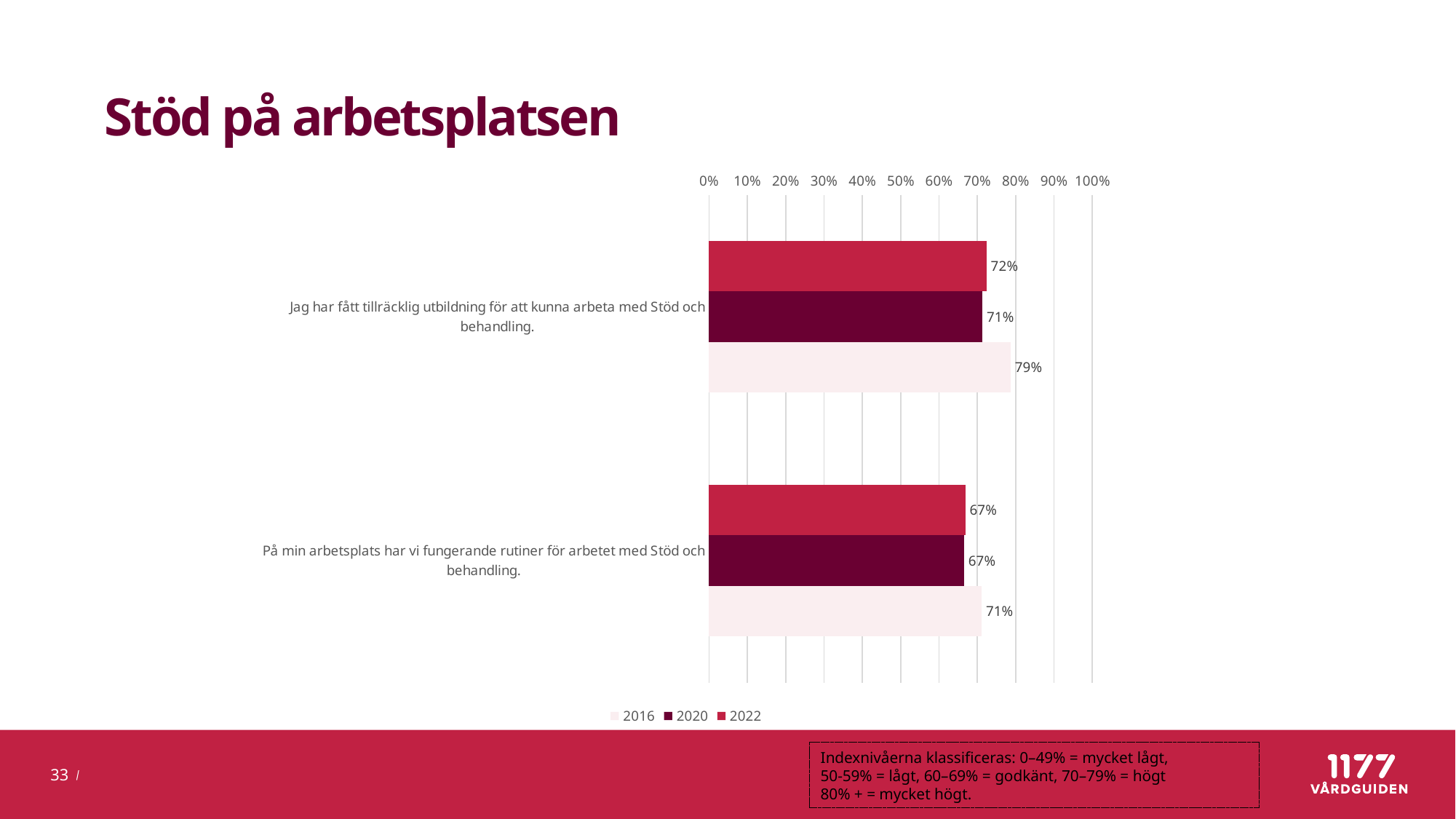
What kind of chart is shown on the slide? Bar chart What is the 2020 value for "Jag har fått tillräcklig utbildning för att kunna arbeta med Stöd och behandling."? 71% How many series does the legend list? 3 What is the 2016 value for "På min arbetsplats har vi fungerande rutiner för arbetet med Stöd och behandling."? 71% What is the difference between the 2016 and 2020 values for "På min arbetsplats har vi fungerande rutiner för arbetet med Stöd och behandling."? 4% What is the title of the slide? Stöd på arbetsplatsen What is the difference between the 2016 and 2022 values for "Jag har fått tillräcklig utbildning för att kunna arbeta med Stöd och behandling."? 7% What is the 2022 value for "På min arbetsplats har vi fungerande rutiner för arbetet med Stöd och behandling."? 67% Which year has the highest value for "Jag har fått tillräcklig utbildning för att kunna arbeta med Stöd och behandling."? 2016 How many categories (statements) are shown on the chart? 2 Which is larger: the 2022 value for "Jag har fått tillräcklig utbildning..." or the 2022 value for "På min arbetsplats har vi fungerande rutiner..."? Jag har fått tillräcklig utbildning för att kunna arbeta med Stöd och behandling. What is the 2016 value for "Jag har fått tillräcklig utbildning för att kunna arbeta med Stöd och behandling."? 79%